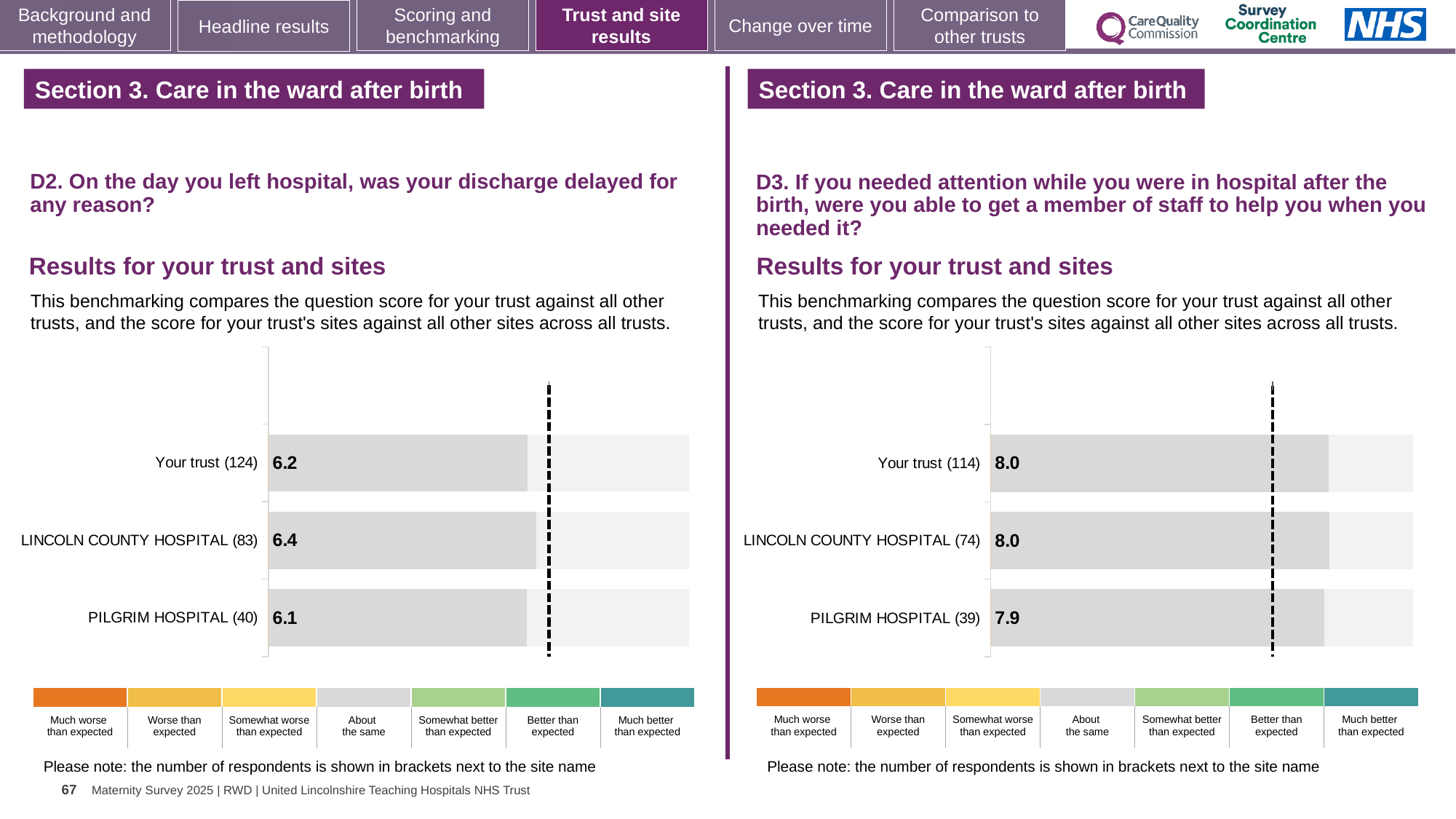
In the D2 chart (left), what is the score for PILGRIM HOSPITAL? 6.1 In the D2 chart (left), what is the score for LINCOLN COUNTY HOSPITAL? 6.4 How many bars are plotted in the D2 chart (left)? 3 In the D2 chart (left), what is the difference between the scores for LINCOLN COUNTY HOSPITAL and PILGRIM HOSPITAL? 0.3 In the D3 chart (right), how many respondents are shown in brackets for LINCOLN COUNTY HOSPITAL? 74 What kind of chart is the D3 chart (right)? Bar chart In the D3 chart (right), what is the score for Your trust? 8.0 In the D2 chart (left), which site or trust has the highest score? LINCOLN COUNTY HOSPITAL In the D3 chart (right), which site has the lowest score? PILGRIM HOSPITAL In the D3 chart (right), what is the score for PILGRIM HOSPITAL? 7.9 In the D2 chart (left), what is the score for Your trust? 6.2 In the D2 chart (left), which site or trust has the lowest score? PILGRIM HOSPITAL